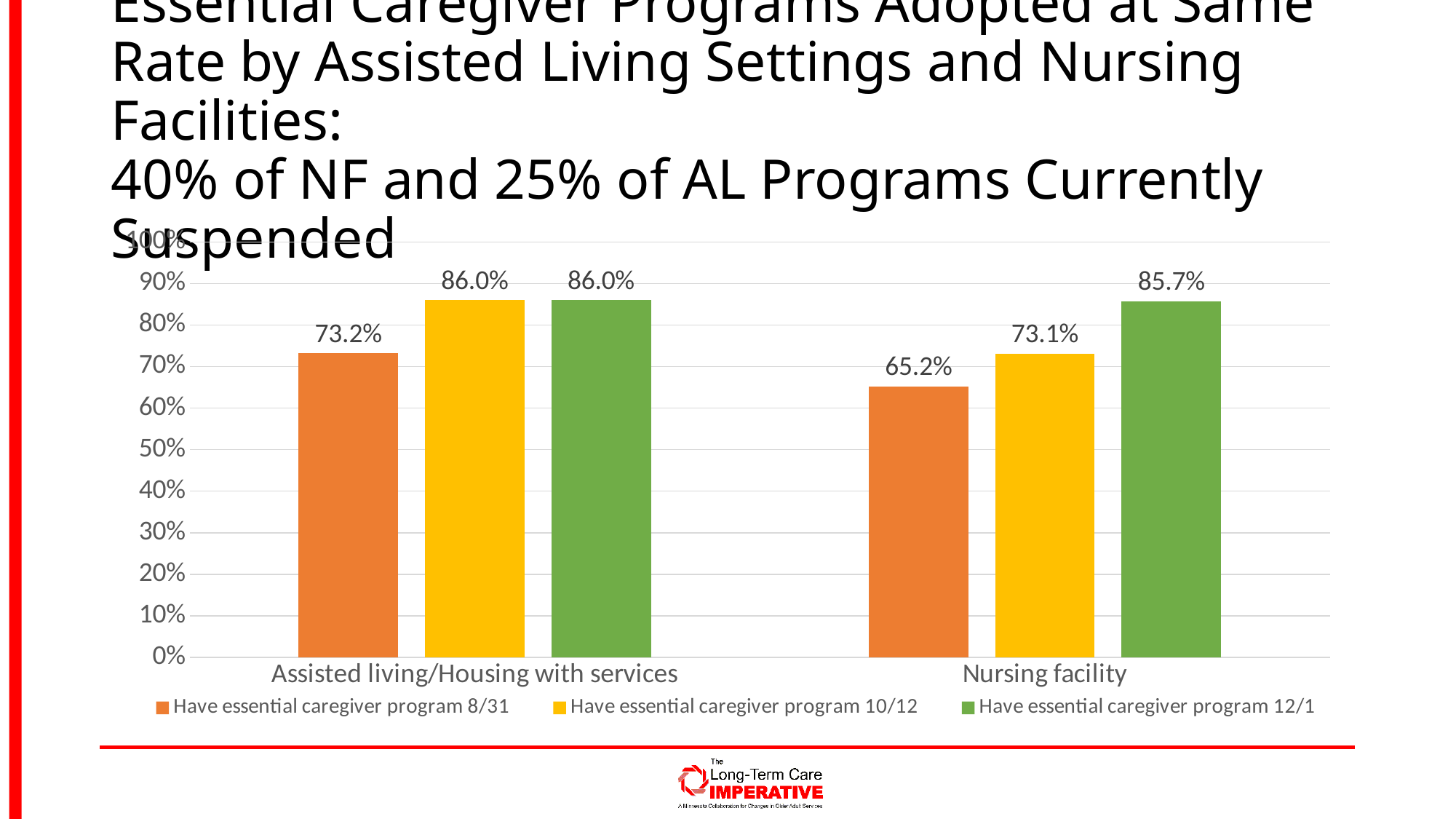
How many categories are shown on the x axis? 2 What kind of chart is shown on the slide? Bar chart What is the difference between the 8/31 values for Assisted living/Housing with services and Nursing facility? 8.0% What percentage of Assisted living/Housing with services settings had an essential caregiver program on 8/31? 73.2% Which is larger for Nursing facility: the 8/31 value or the 10/12 value? 10/12 Which category has the lowest value for 'Have essential caregiver program 8/31'? Nursing facility Which colour represents 'Have essential caregiver program 12/1' in the legend? Green What is the difference between the 12/1 and 8/31 values for Nursing facility? 20.5% How many series does the legend list? 3 What percentage of Assisted living/Housing with services settings had an essential caregiver program on 10/12? 86.0% What percentage of Nursing facilities had an essential caregiver program on 10/12? 73.1% What percentage of Nursing facilities had an essential caregiver program on 12/1? 85.7%